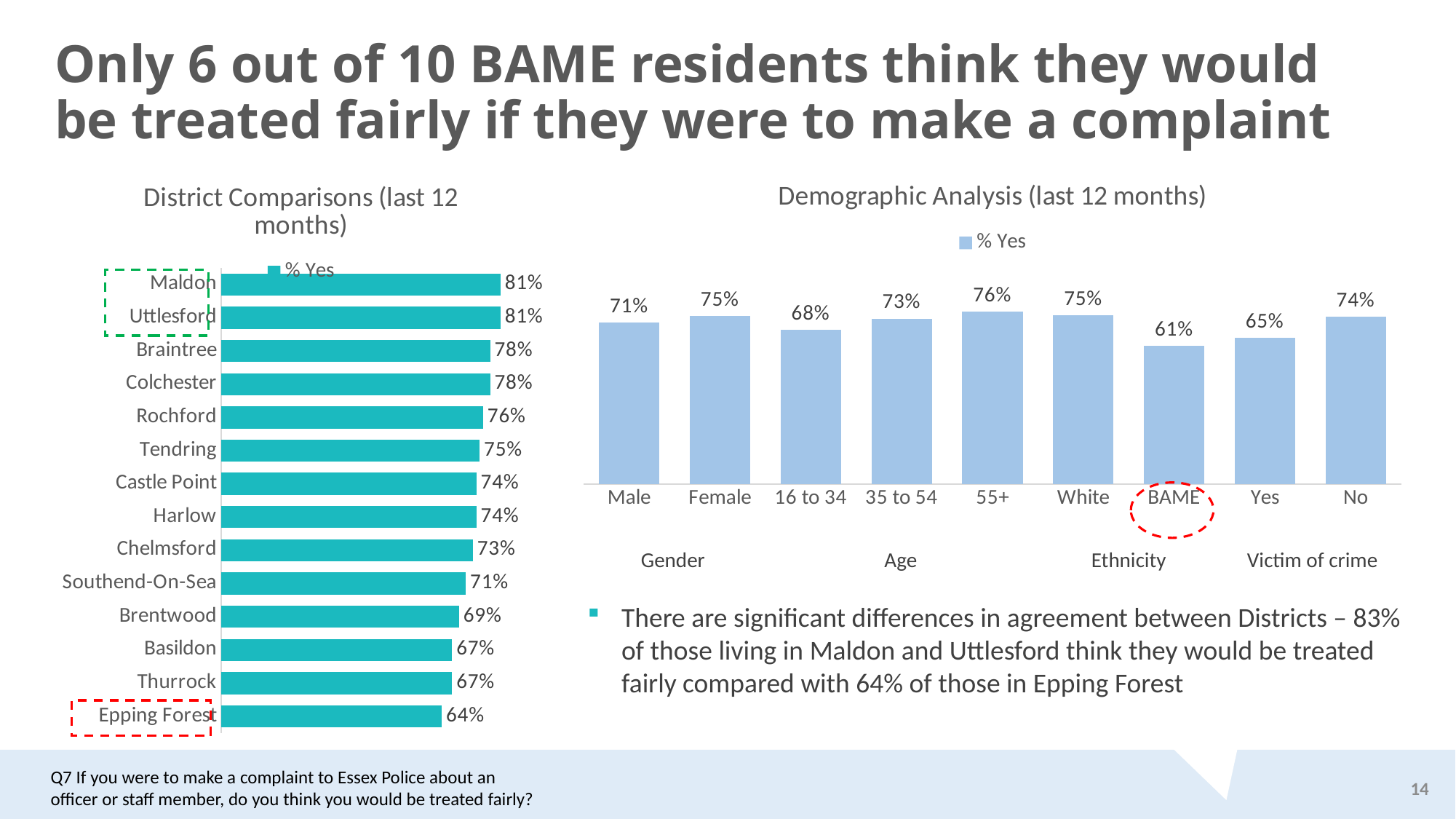
In the Demographic Analysis chart, what is the difference between the values for White and BAME? 14% What type of chart is the Demographic Analysis chart? Bar chart In the Demographic Analysis chart, which category has the lowest % Yes value? BAME In the District Comparisons chart, what is the % Yes value for Epping Forest? 64% In the District Comparisons chart, what is the % Yes value for Colchester? 78% In the District Comparisons chart, how many districts are shown? 14 In the Demographic Analysis chart, which category has the highest % Yes value? 55+ In the District Comparisons chart, what is the difference between the values for Maldon and Epping Forest? 17% In the Demographic Analysis chart, how many categories are plotted? 9 In the District Comparisons chart, which has a higher value, Rochford or Brentwood? Rochford In the District Comparisons chart, which district has the lowest % Yes value? Epping Forest In the Demographic Analysis chart, what is the % Yes value for BAME? 61%